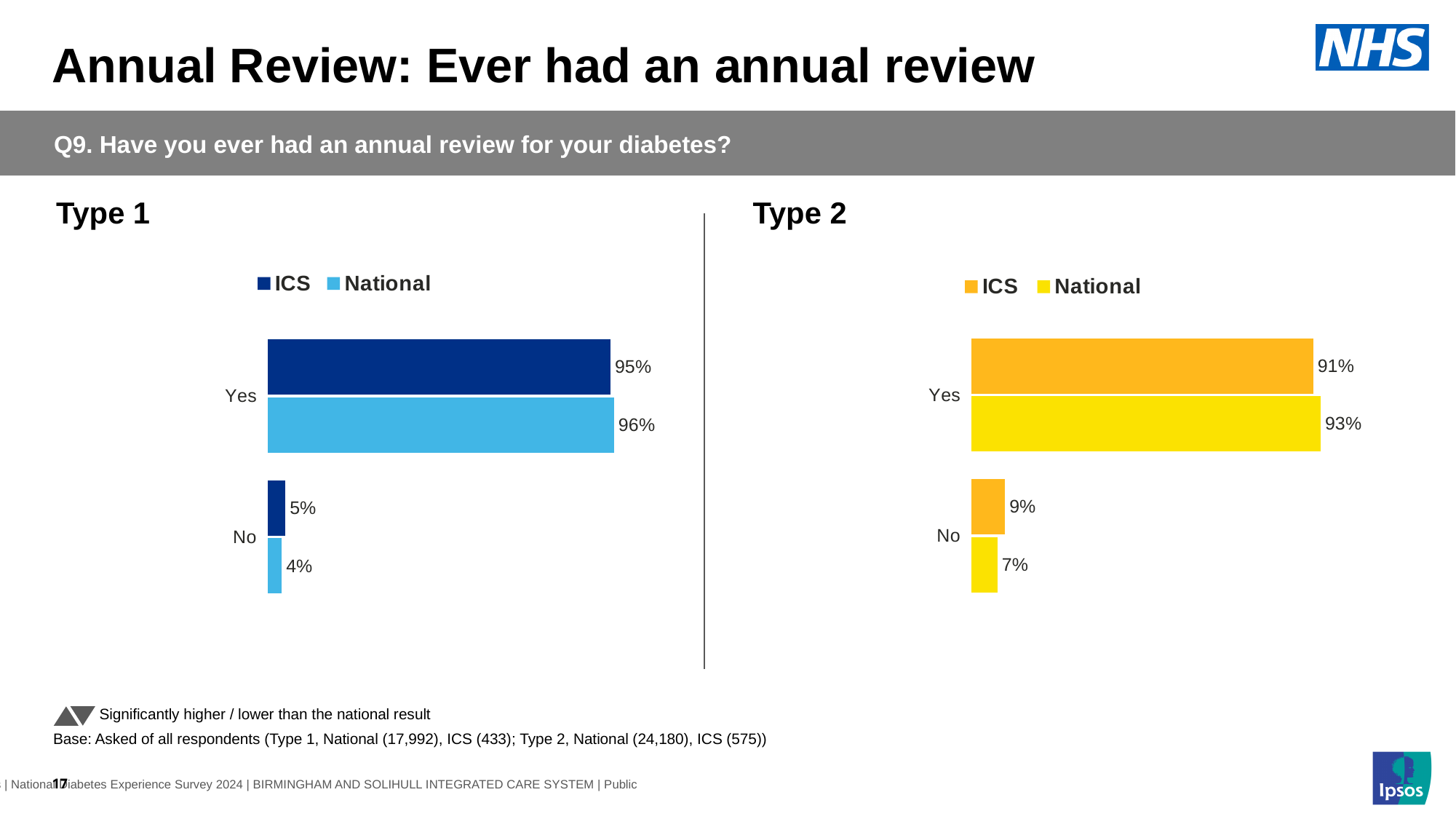
In the Type 2 chart, what is the difference between the National and ICS values for Yes? 2% In the Type 2 chart, what is the ICS value for No? 9% In the Type 2 chart, which is larger for No: ICS or National? ICS What kind of chart is the Type 1 chart? Bar chart How many categories are shown in the Type 1 chart? 2 In the Type 2 chart, what is the National value for Yes? 93% In the Type 1 chart, what is the National value for No? 4% In the Type 1 chart, what is the difference between the ICS and National values for No? 1% In the Type 1 chart, what is the ICS value for Yes? 95% In the Type 1 chart, which category has the highest National value? Yes In the Type 2 chart, which category has the lowest ICS value? No How many series does the legend of the Type 2 chart list? 2